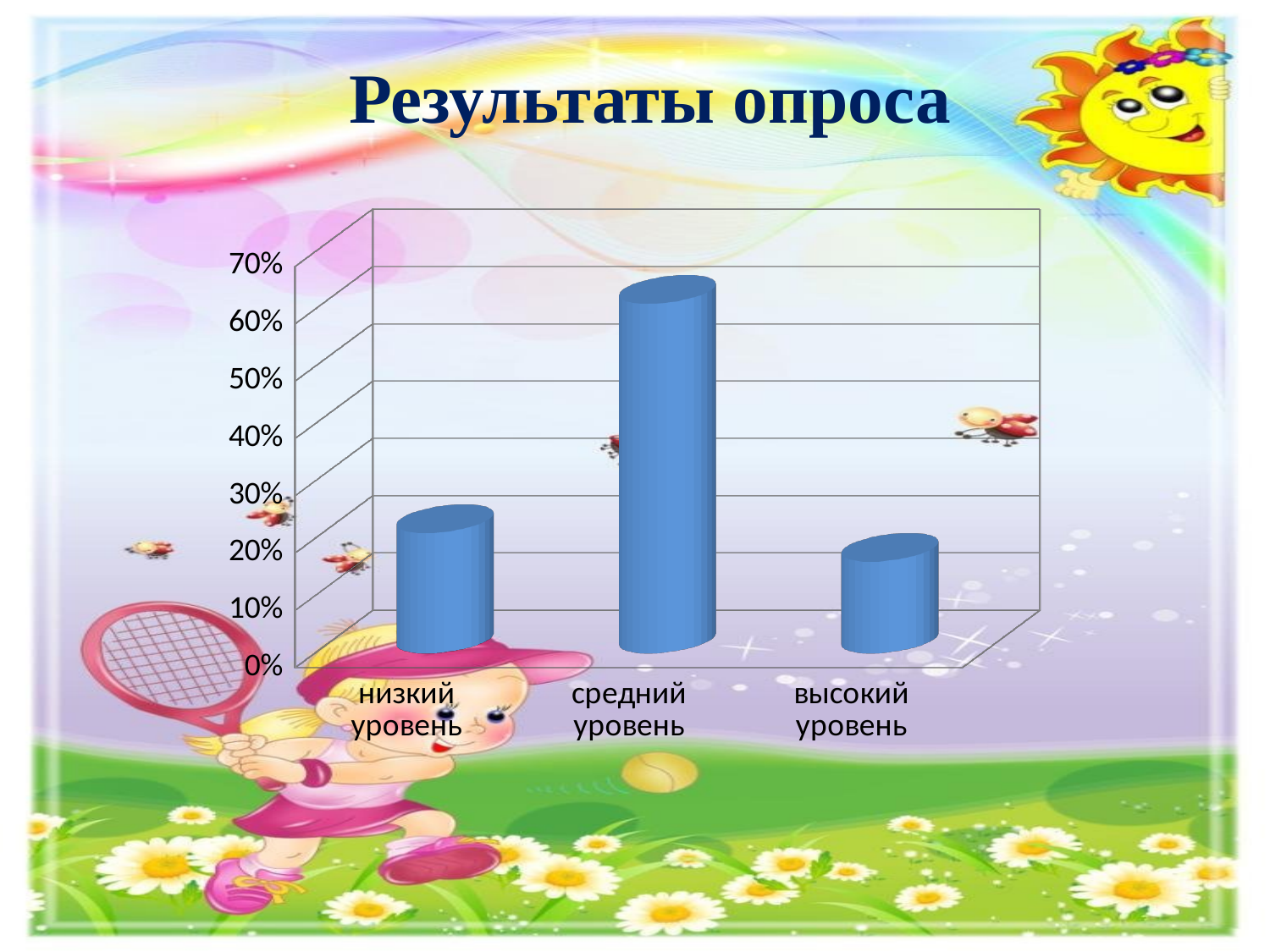
Is the value for средний уровень greater or less than 50%? greater What is the title of the slide with the chart? Результаты опроса Which category has the highest value? средний уровень Which category has the lowest value? высокий уровень What kind of chart is shown on the slide? bar chart How many categories are shown on the chart? 3 Is the value for низкий уровень greater or less than 30%? less Which is larger, the value for низкий уровень or the value for высокий уровень? низкий уровень Is the value for низкий уровень greater or less than 10%? greater What is the highest value shown on the vertical axis? 70%